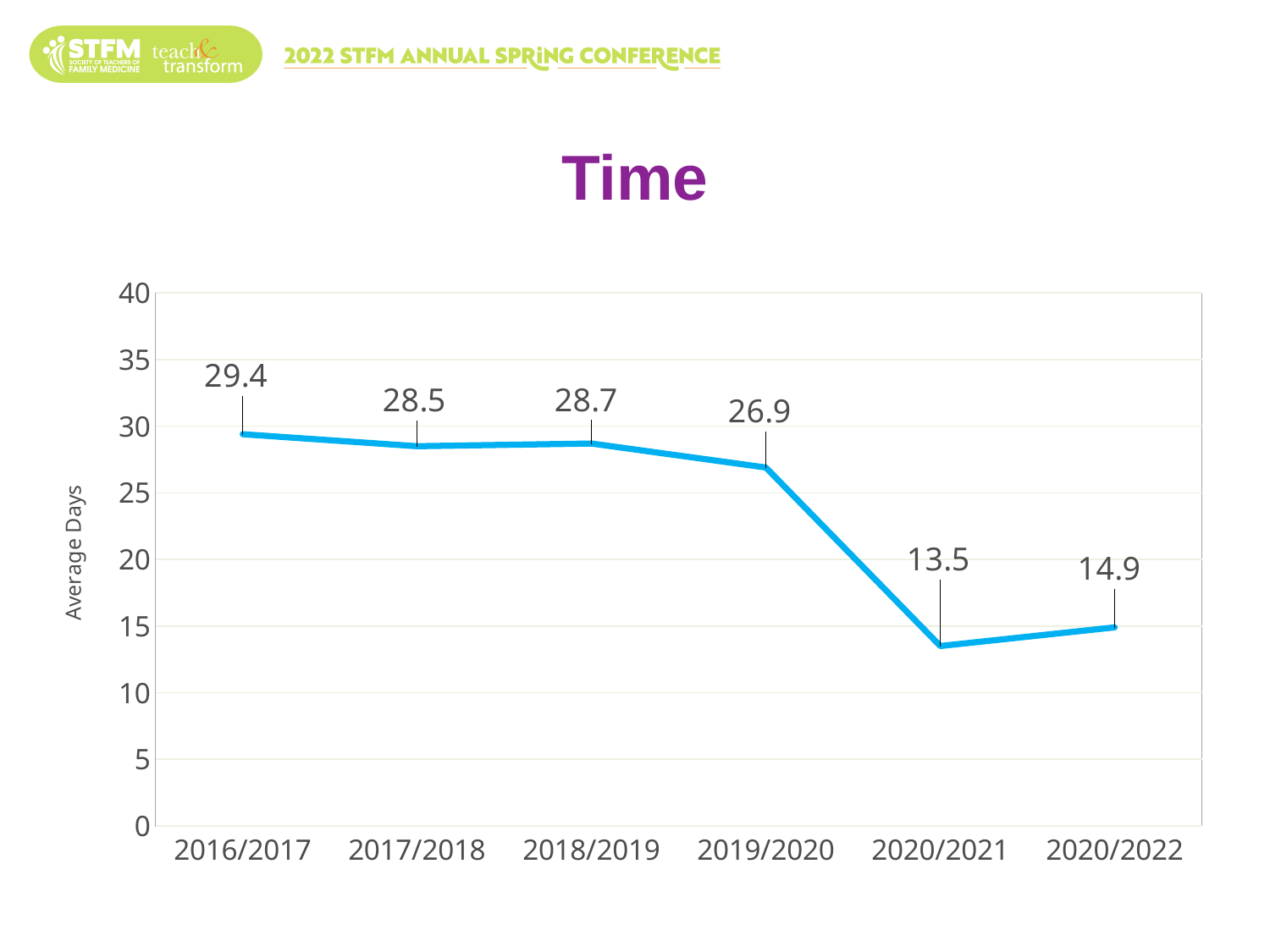
How many periods are plotted on the chart? 6 What is the average days value for 2016/2017? 29.4 Which period has the lowest average days? 2020/2021 What kind of chart is shown on the slide? line chart What is the average days value for 2019/2020? 26.9 Is the value for 2020/2022 greater or less than 20? less Which is larger, the value for 2017/2018 or the value for 2018/2019? 2018/2019 Which period has the highest average days? 2016/2017 What is the difference in average days between 2019/2020 and 2020/2021? 13.4 What is the average days value for 2020/2021? 13.5 What is the label of the vertical axis? Average Days What is the difference in average days between 2020/2022 and 2020/2021? 1.4